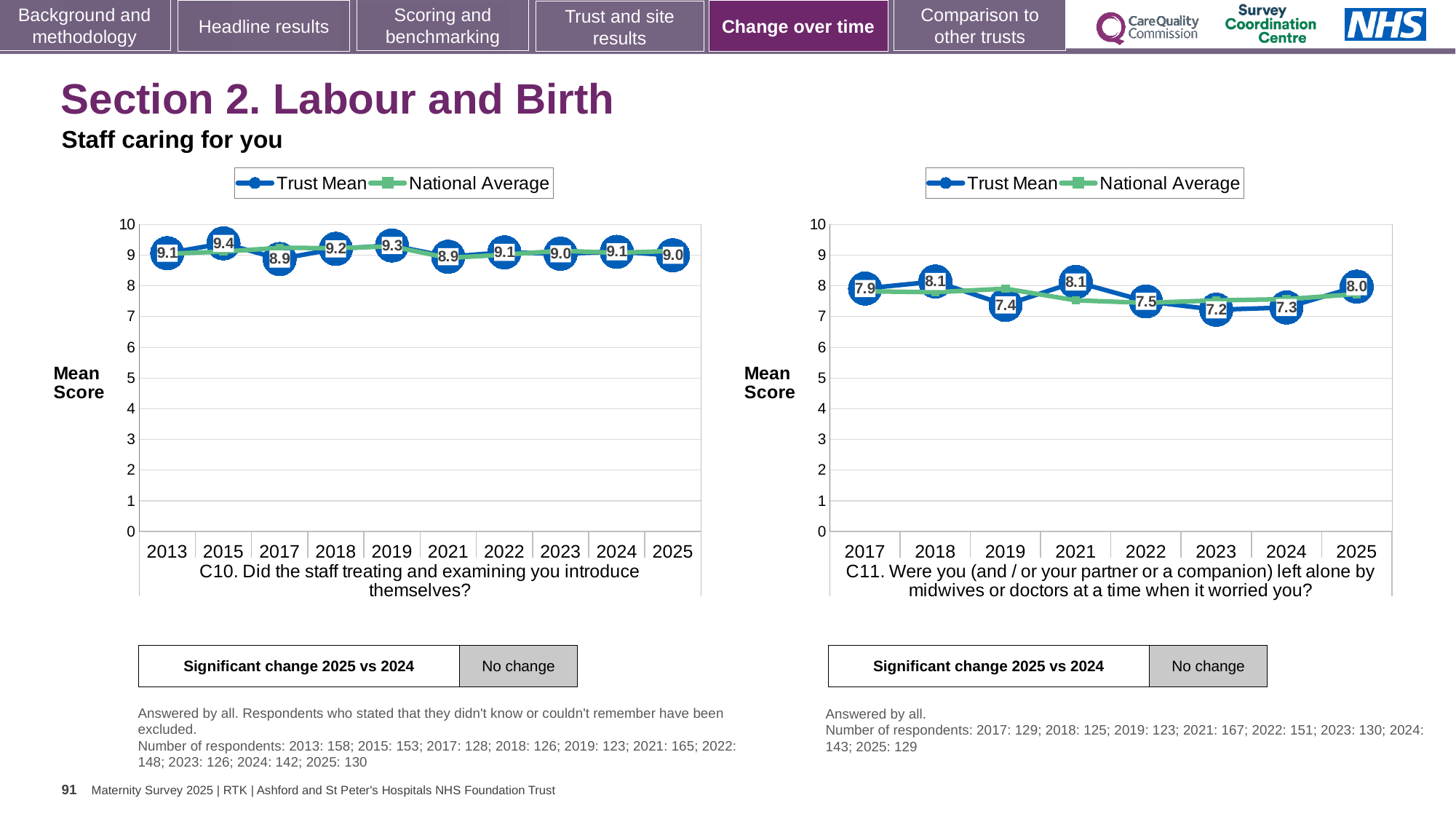
In the left chart (C10), how many years are shown on the x axis? 10 What type of chart is the left chart (C10)? Line chart In the right chart (C11), what is the Trust Mean score for 2019? 7.4 In the left chart (C10), what is the Trust Mean score for 2015? 9.4 In the right chart (C11), is the Trust Mean score for 2024 greater or less than the score for 2025? less In the left chart (C10), which year has the highest Trust Mean score? 2015 In the right chart (C11), what is the Trust Mean score for 2025? 8.0 In the left chart (C10), what is the difference between the Trust Mean scores for 2015 and 2017? 0.5 How many series does the legend of the right chart (C11) list? 2 In the right chart (C11), which year has the lowest Trust Mean score? 2023 In the left chart (C10), what is the Trust Mean score for 2025? 9.0 In the right chart (C11), what is the difference between the Trust Mean scores for 2018 and 2023? 0.9